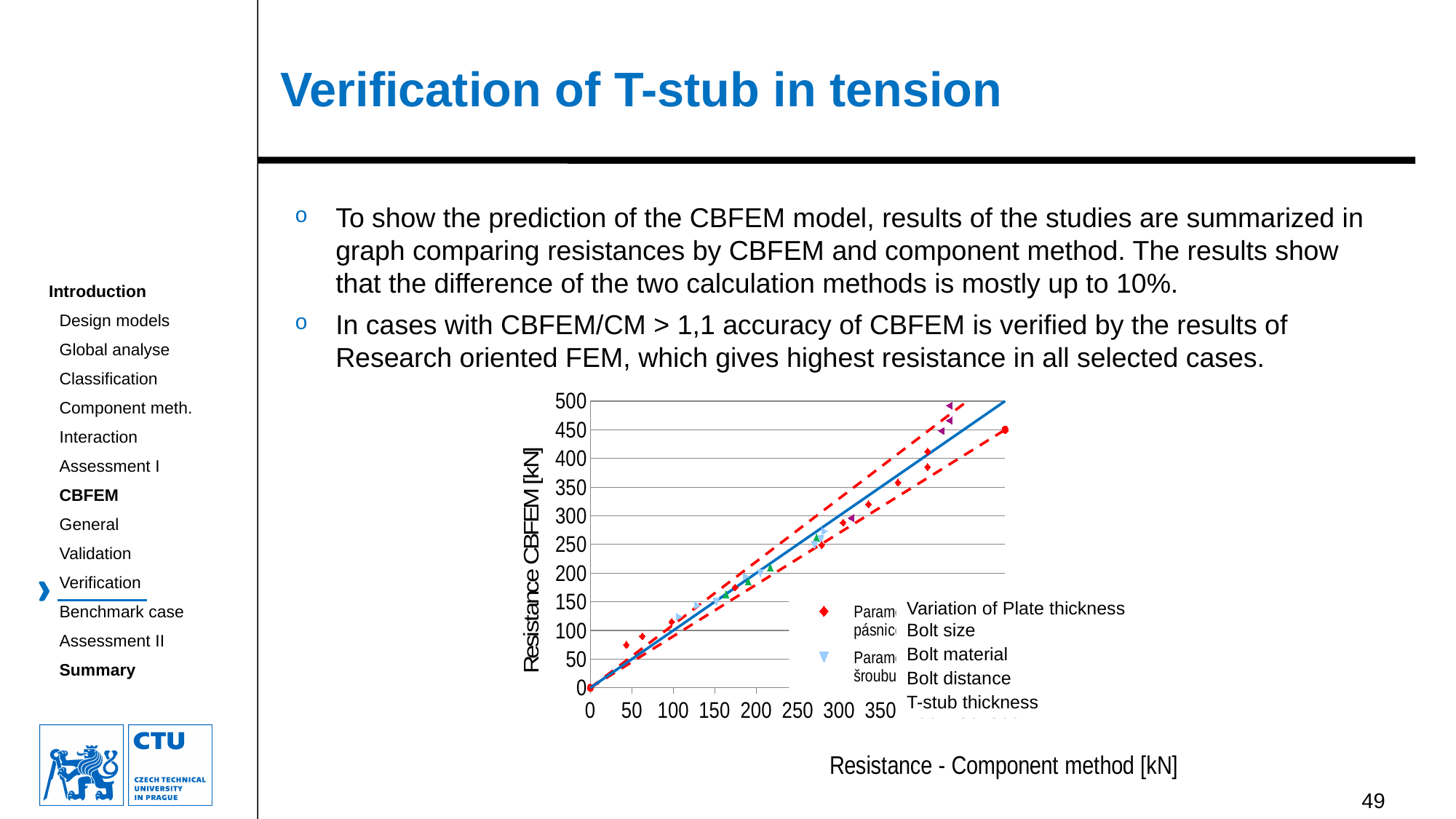
What is the highest value shown on the vertical axis of the chart? 500 Are the CBFEM resistances of the red points plotted near 50 kN on the x axis greater or less than 100? less What kind of chart is shown on the slide? scatter chart What is the title of the vertical axis of the chart? Resistance CBFEM [kN] What is the title of the horizontal axis of the chart? Resistance - Component method [kN] Is the CBFEM resistance of the highest purple point on the chart greater or less than 450? greater Is the CBFEM resistance of the red point at the far right of the chart (around 450 kN by the component method) greater or less than 400? greater As the component method resistance increases along the x axis, do the plotted CBFEM resistances rise or fall? rise